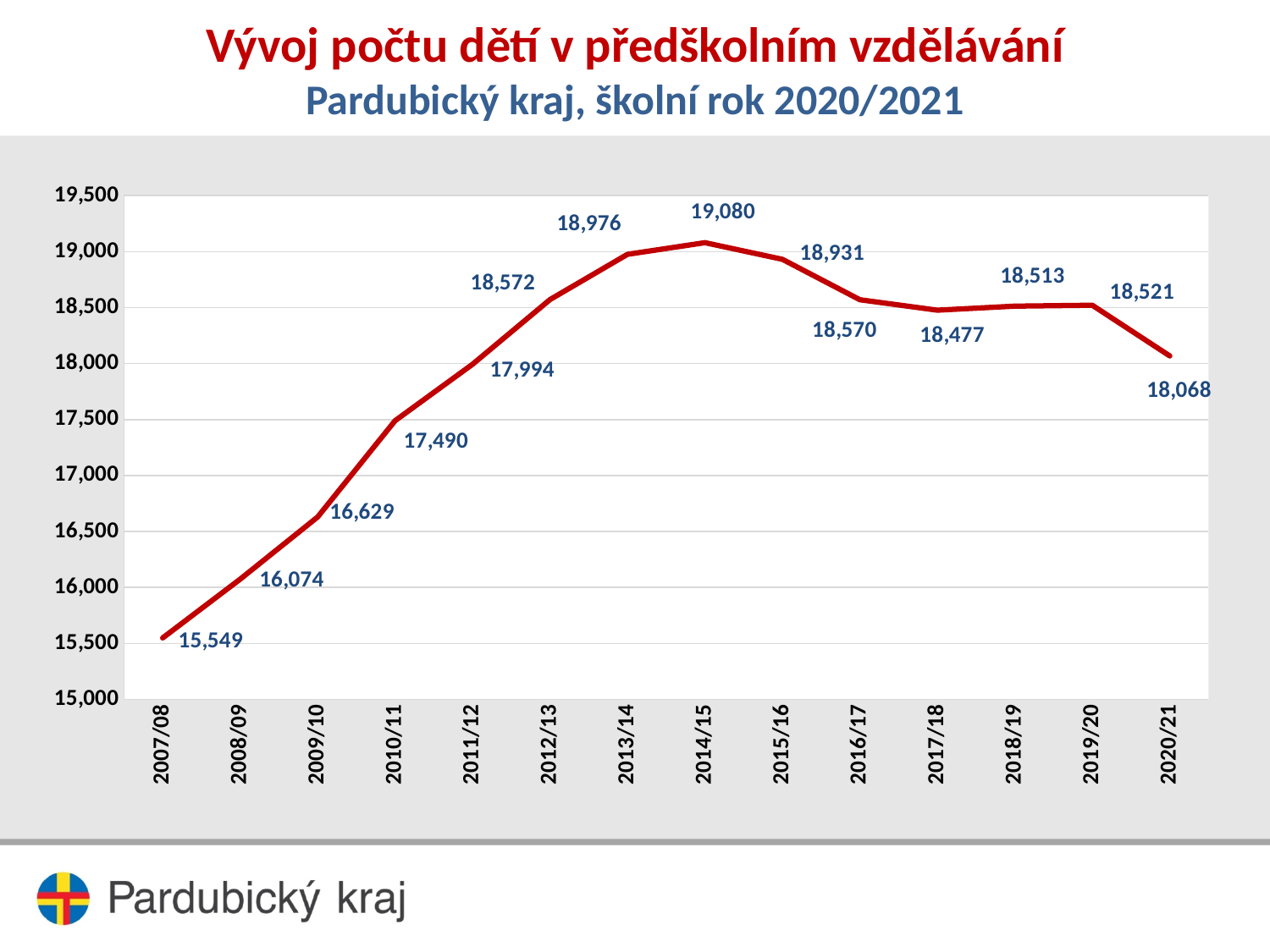
Which school year has the lowest value on the chart? 2007/08 Which school year has the highest value on the chart? 2014/15 How many school years are plotted on the chart? 14 What is the difference between the values for 2019/20 and 2020/21? 453 What value is shown for the school year 2007/08? 15,549 What type of chart is shown on the slide? line chart Which school year has a larger value, 2012/13 or 2016/17? 2012/13 Does the value rise or fall between 2007/08 and 2014/15? rise What colour is the line on the chart? red What is the number of children in preschool education in the school year 2014/15? 19,080 What value is shown for the school year 2020/21? 18,068 What is the difference between the highest value (2014/15) and the lowest value (2007/08)? 3,531